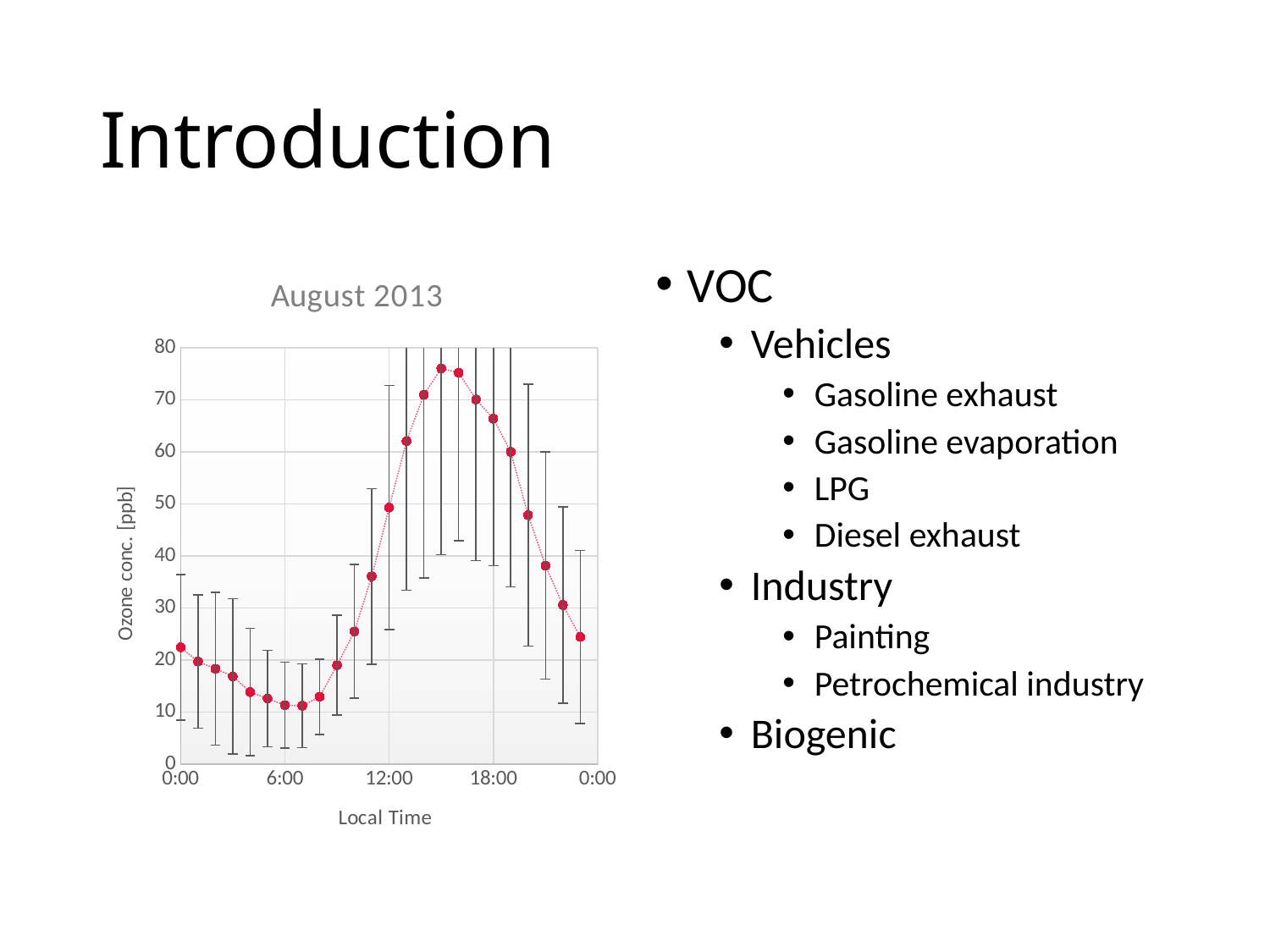
Is the ozone concentration at 15:00 greater or less than 70 ppb? greater What kind of chart is shown on the slide? line chart Is the ozone concentration at 0:00 greater or less than 30 ppb? less What is the label of the y axis of the chart? Ozone conc. [ppb] Is the ozone concentration at 21:00 greater or less than 30 ppb? greater What is the title of the chart? August 2013 Does the ozone concentration rise or fall between 16:00 and 23:00? fall Does the ozone concentration rise or fall between 6:00 and 15:00? rise Which has the higher ozone concentration, 9:00 or 21:00? 21:00 How many data points are plotted on the chart? 24